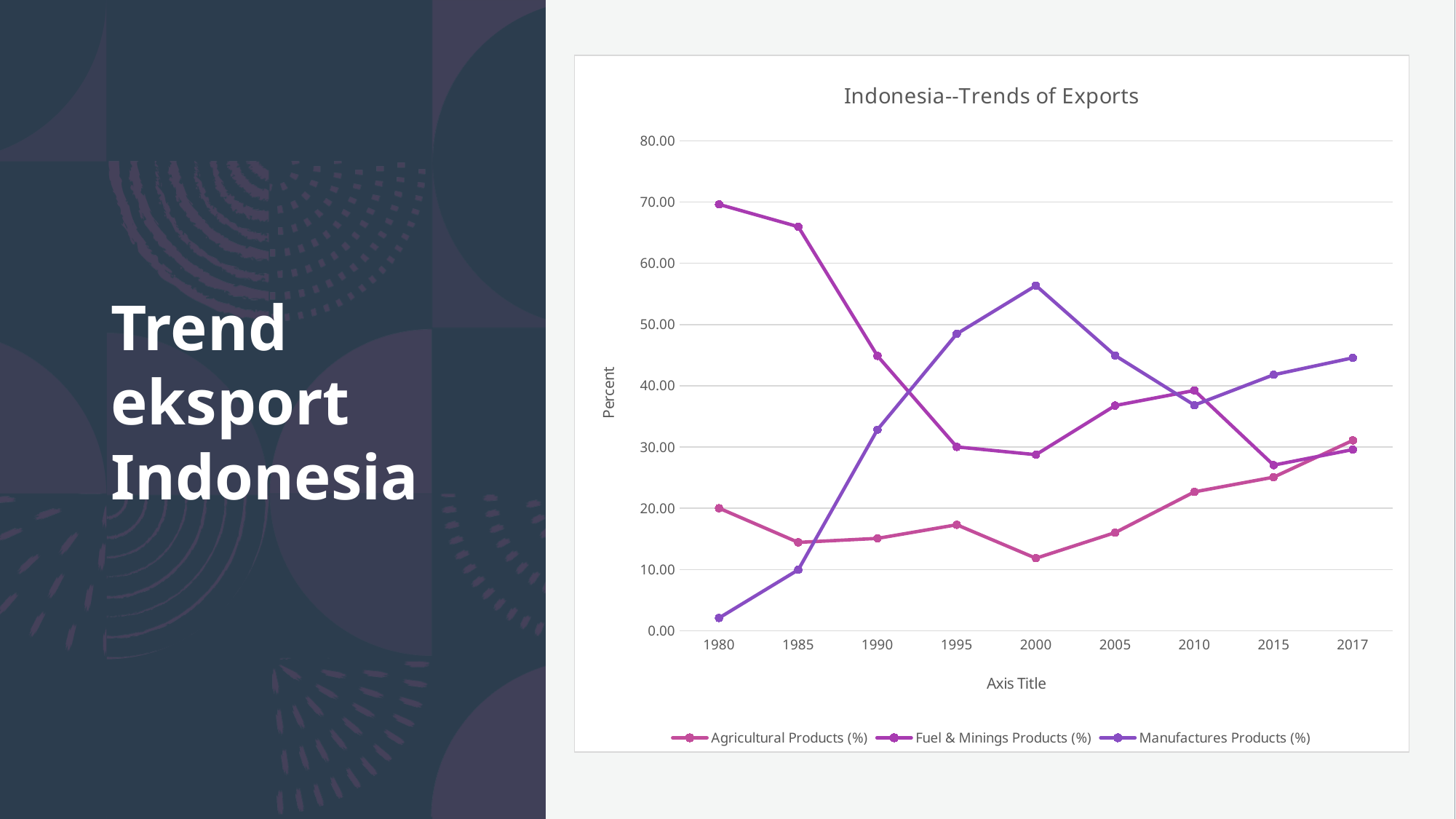
In 2000, which series has the larger value: Manufactures Products (%) or Fuel & Minings Products (%)? Manufactures Products (%) In which year is the Fuel & Minings Products (%) series at its highest? 1980 In which year is the Manufactures Products (%) series at its lowest? 1980 How many series does the legend list? 3 What is the title of the chart? Indonesia--Trends of Exports How many years are shown along the x axis? 9 What kind of chart is shown on the slide? line chart Does the Manufactures Products (%) series rise or fall from 1980 to 2000? rise Is the value for Manufactures Products (%) in 2000 greater or less than 50.00? greater In which year is the Agricultural Products (%) series at its highest? 2017 Is the value for Agricultural Products (%) in 2000 greater or less than 20.00? less Is the value for Fuel & Minings Products (%) in 1980 greater or less than 60.00? greater